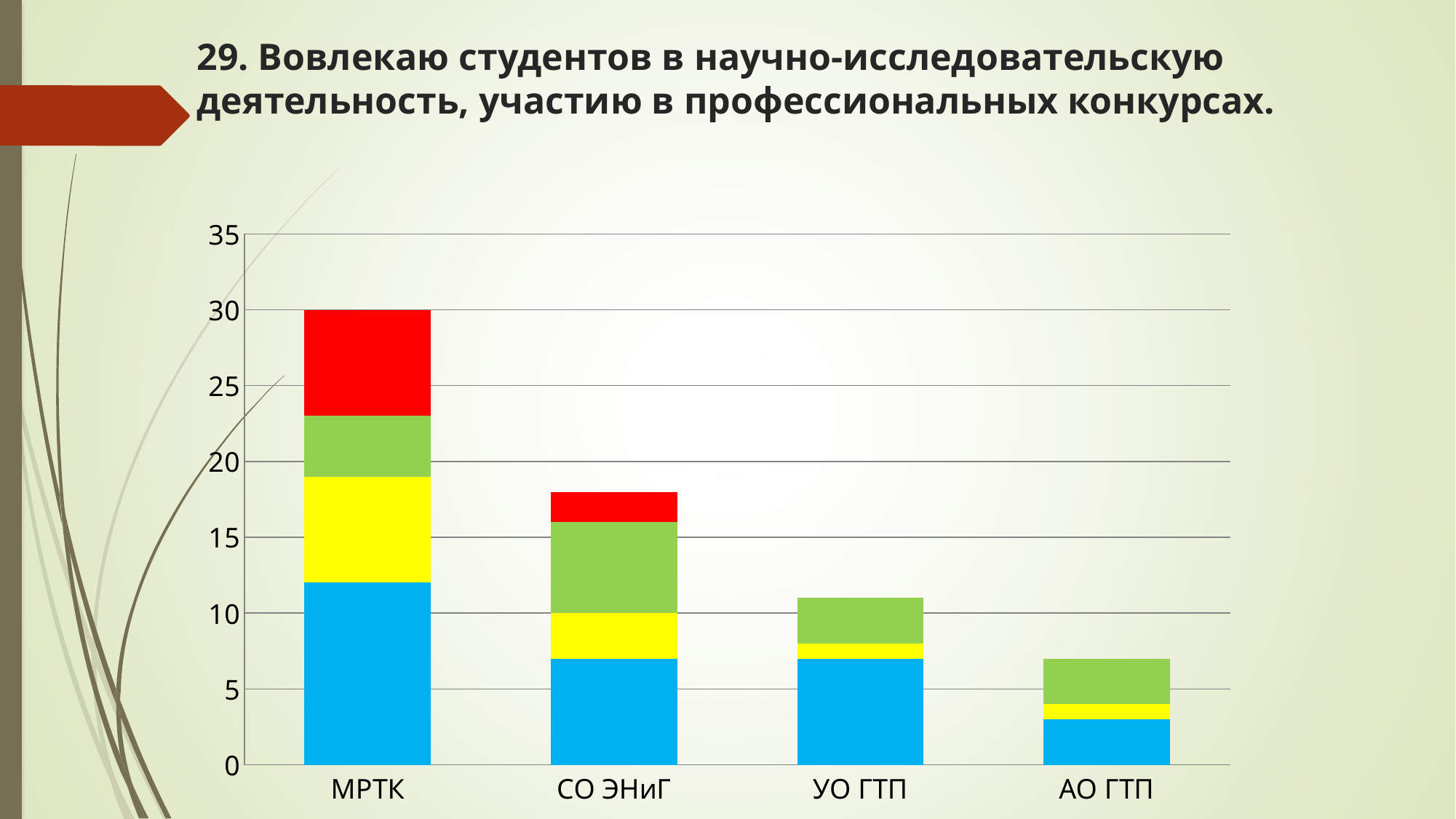
What colour is the topmost segment of the МРТК bar? Red Is the total for СО ЭНиГ greater or less than 20? less Is the total for УО ГТП greater or less than 10? greater How many categories are shown on the x axis of the chart? 4 What is the total height of the stacked bar for МРТК? 30 Is the total for АО ГТП greater or less than 10? less Which category has the shortest stacked bar? АО ГТП What type of chart is shown on the slide? Stacked bar chart Which category has the tallest stacked bar? МРТК Which stacked bar is taller, СО ЭНиГ or УО ГТП? СО ЭНиГ Do the bar totals rise or fall from left to right along the x axis? fall